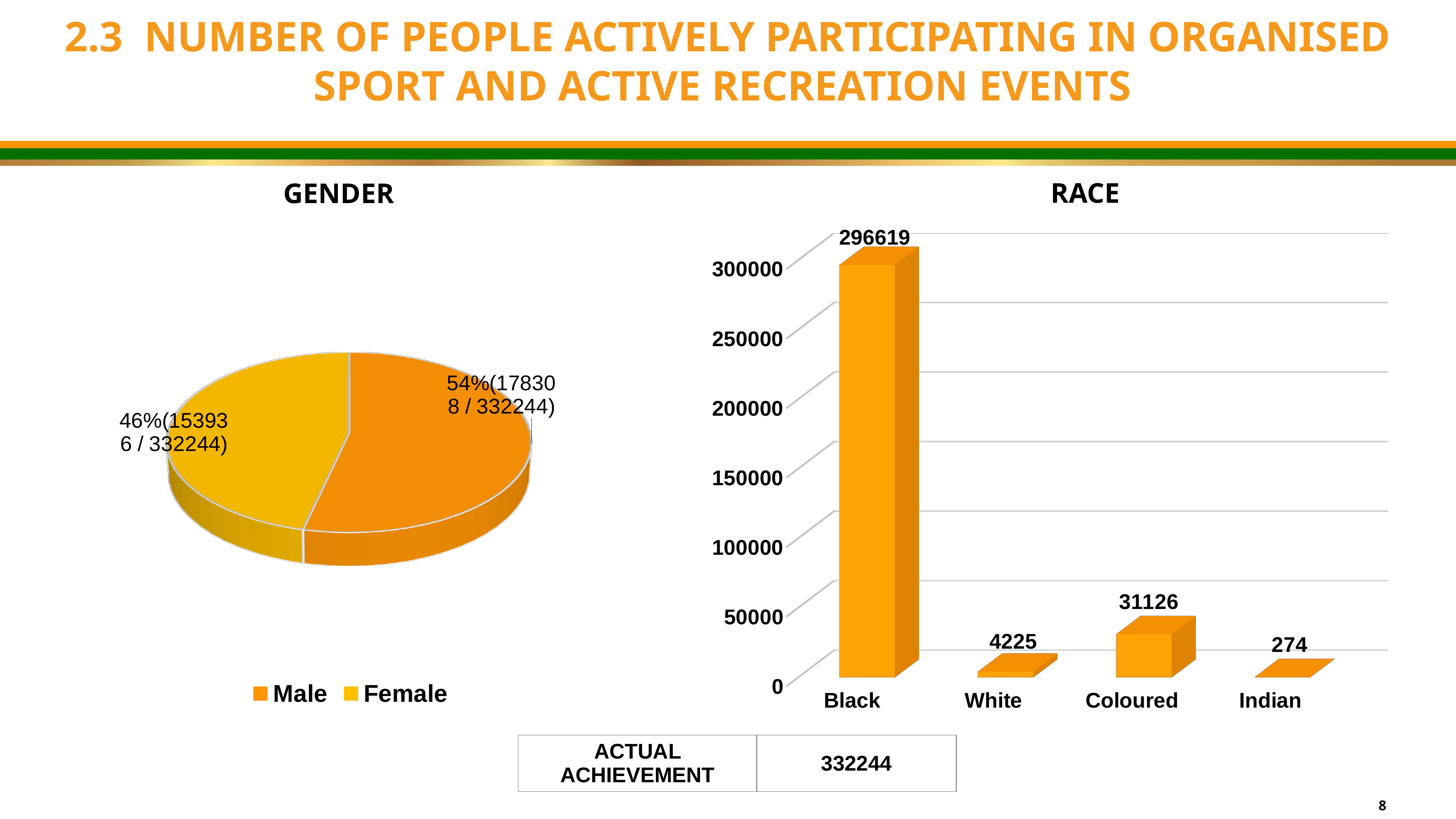
What kind of chart is the RACE chart? bar chart In the GENDER chart, what share of the pie is Male? 54% In the RACE chart, what is the value for Black? 296619 How many entries does the legend of the GENDER chart list? 2 In the RACE chart, what is the value for White? 4225 In the RACE chart, how many categories are shown on the x axis? 4 In the RACE chart, which category has the highest value? Black In the GENDER chart, what share of the pie is Female? 46% In the RACE chart, which category has the lowest value? Indian In the RACE chart, which is larger, the value for White or the value for Indian? White In the RACE chart, what is the difference between the values for Coloured and White? 26901 In the RACE chart, what is the value for Coloured? 31126